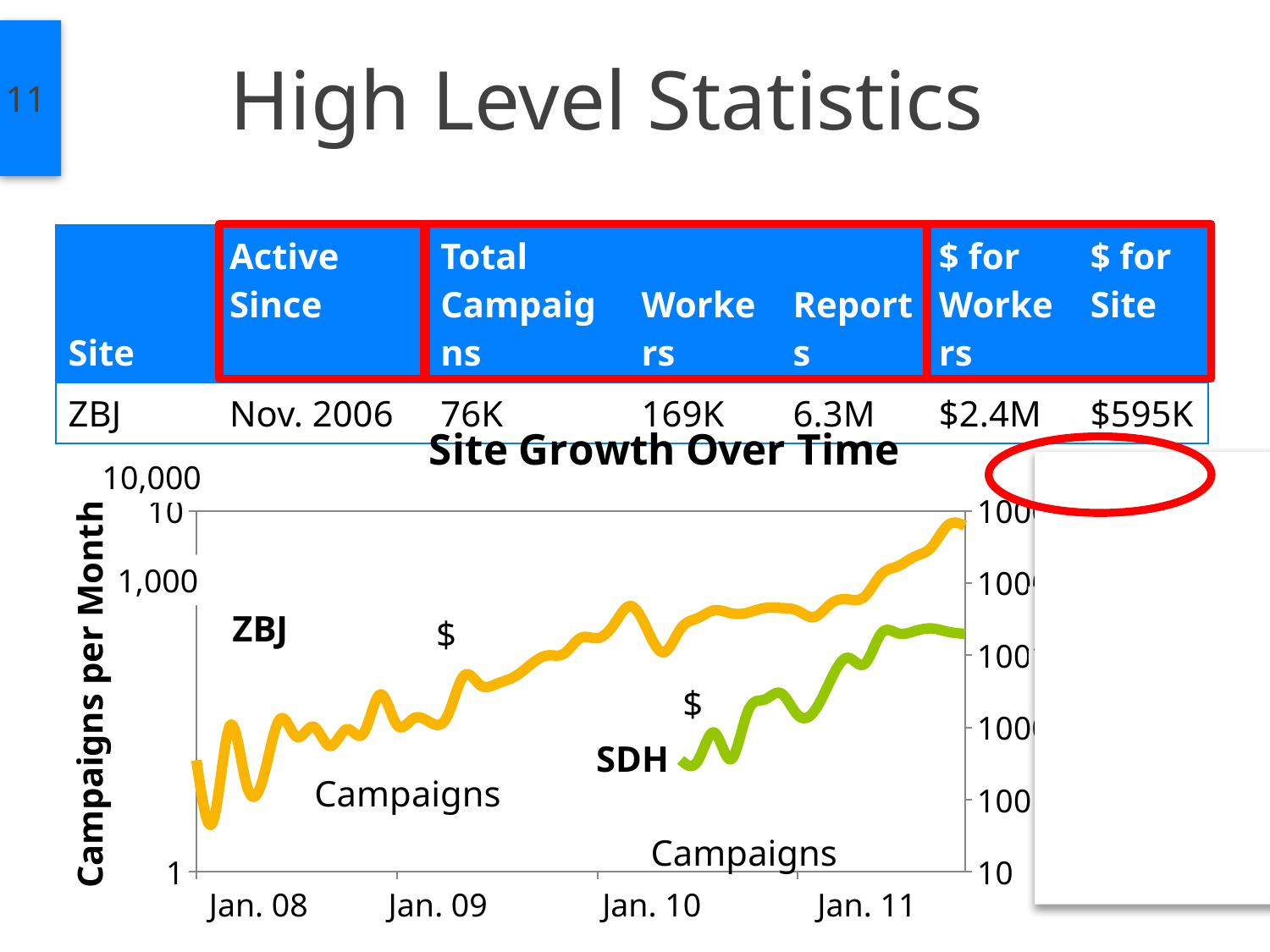
What is the title of the chart on the slide? Site Growth Over Time Does the ZBJ campaigns line rise or fall overall from Jan. 08 to the end of the chart? rise What is the label on the left vertical axis of the chart? Campaigns per Month Which site's line is higher throughout the period where both lines are plotted? ZBJ Which site's campaigns line begins earlier on the x axis, ZBJ or SDH? ZBJ At Jan. 11, which site has more campaigns per month, ZBJ or SDH? ZBJ How many sites are plotted as lines in the 'Site Growth Over Time' chart? 2 What kind of chart is 'Site Growth Over Time'? line chart Does the SDH campaigns line rise or fall overall from Jan. 10 to the end of the chart? rise How many year labels are shown on the x axis of the chart? 4